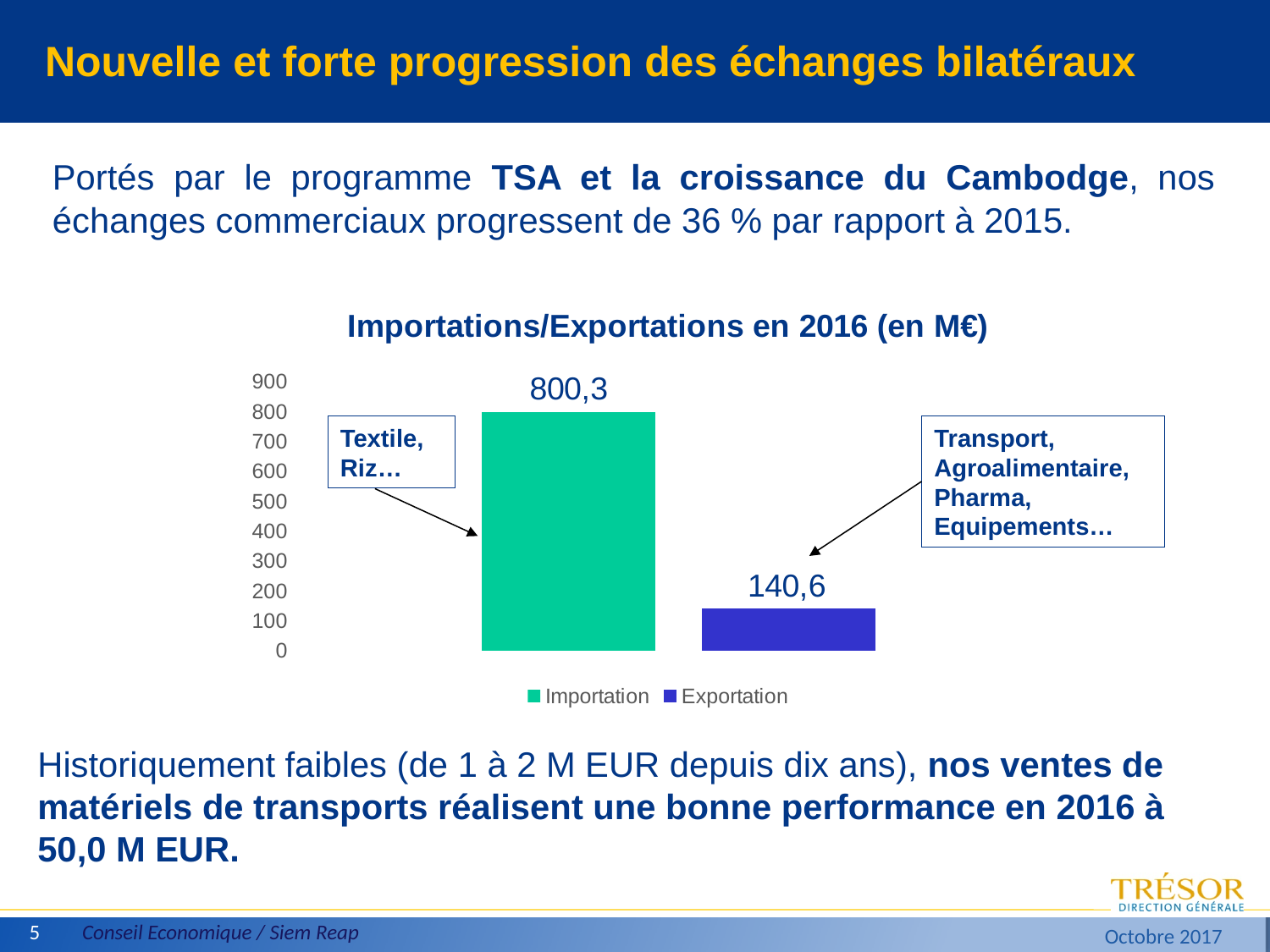
Which series has the lowest value in the chart? Exportation How many series does the legend list? 2 What is the difference between the Importation and Exportation values? 659,7 What colour is the Exportation bar? blue What is the value for Importation in the chart? 800,3 What kind of chart is shown on the slide? bar chart Is the value for Exportation greater or less than 200? less What is the highest value shown on the vertical axis? 900 What is the title of the chart? Importations/Exportations en 2016 (en M€) Is the value for Importation greater or less than 700? greater Which series has the highest value, Importation or Exportation? Importation What is the value for Exportation in the chart? 140,6